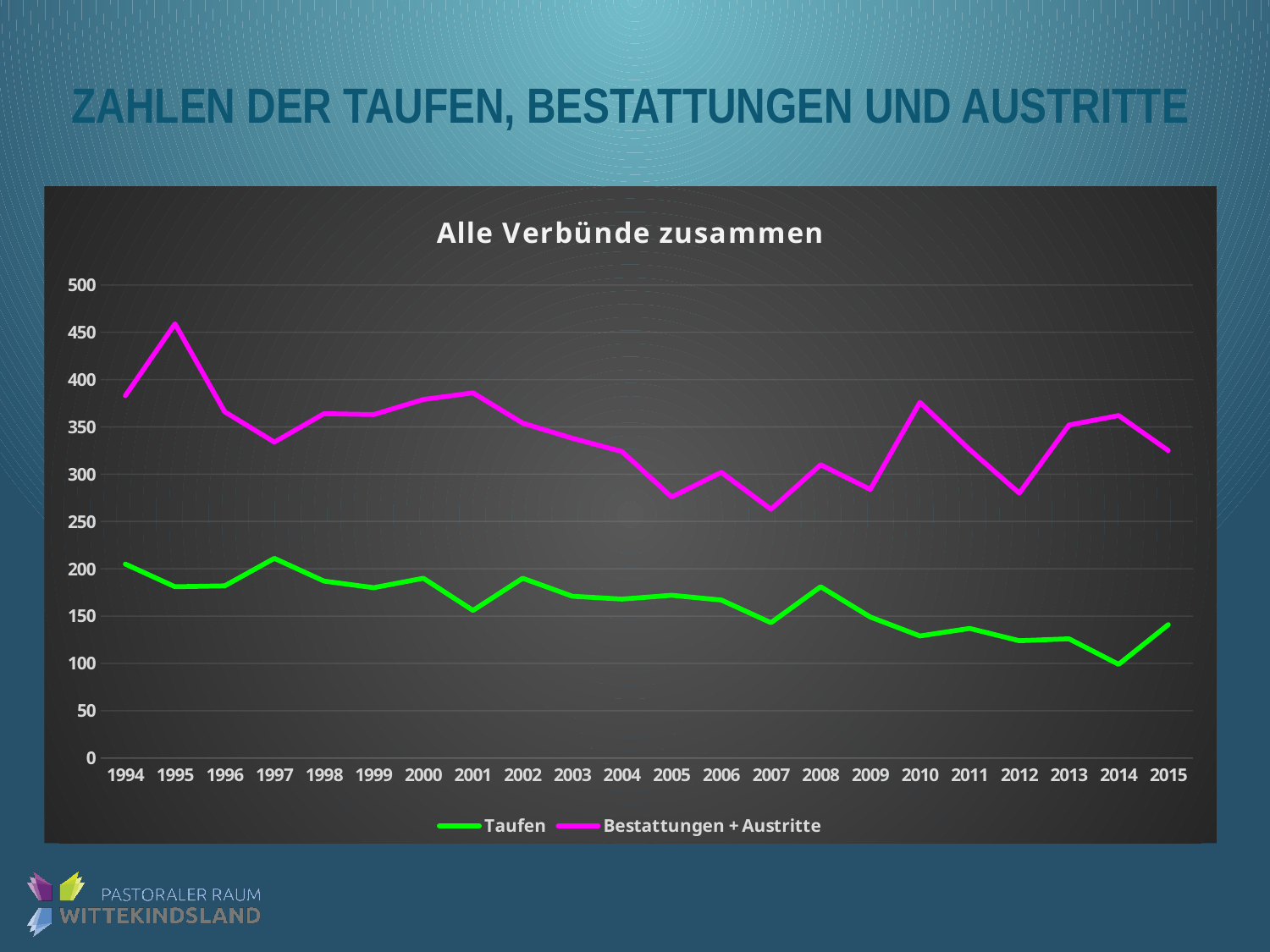
In which year is the value for Taufen lowest? 2014 How many series does the legend list? 2 In 2015, which series has the larger value, Taufen or Bestattungen + Austritte? Bestattungen + Austritte What is the title of the chart? Alle Verbünde zusammen Is the value for Taufen in 2014 greater or less than 150? less Is the value for Bestattungen + Austritte in 2010 greater or less than 350? greater Is the value for Bestattungen + Austritte in 2007 greater or less than 300? less Do the values for Taufen generally rise or fall from 1994 to 2015? fall How many years are plotted along the x axis? 22 What kind of chart is shown on the slide? line chart In which year is the value for Bestattungen + Austritte highest? 1995